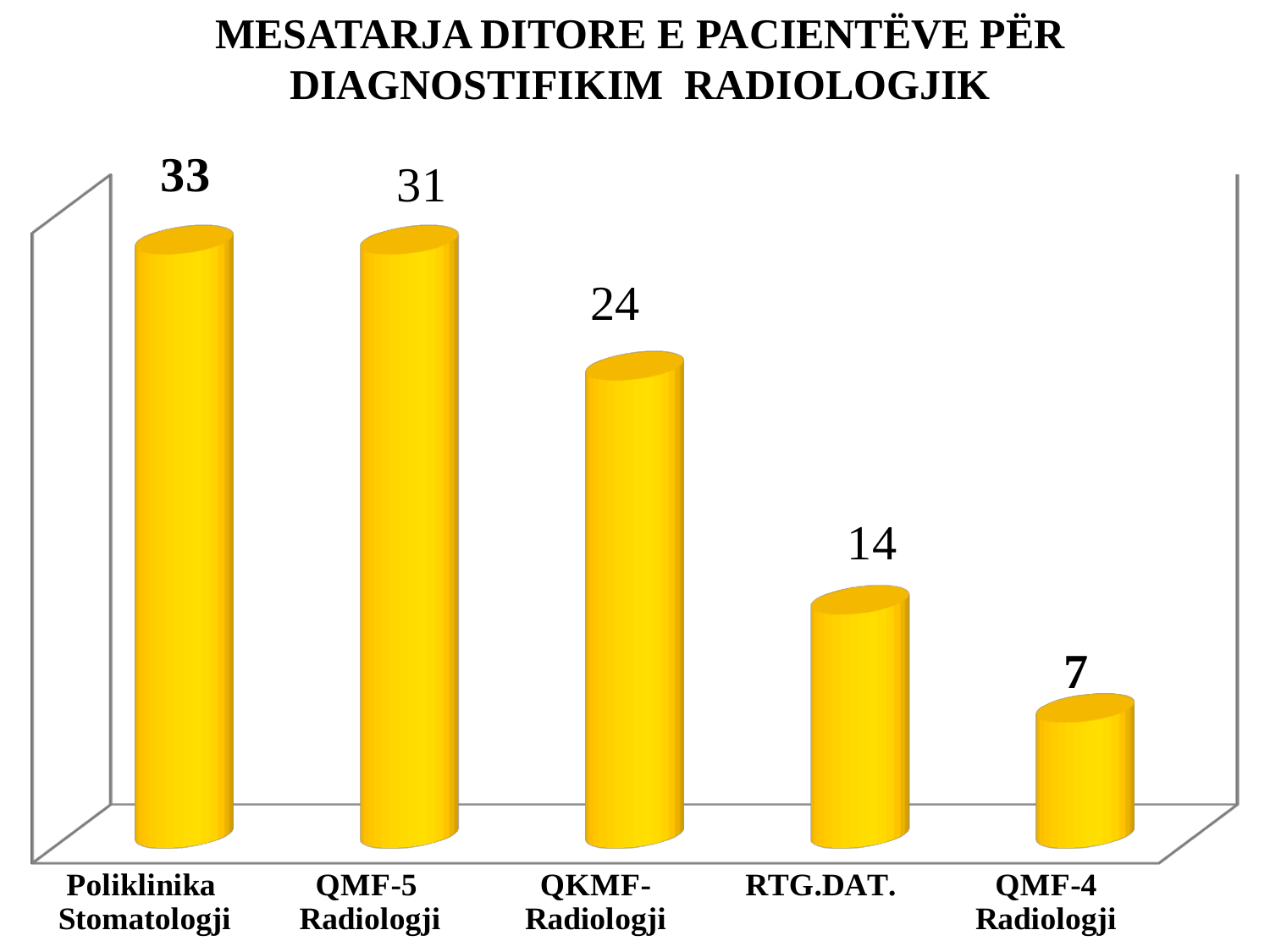
Do the values rise or fall from left to right along the x axis? fall What is the value for QMF-5 Radiologji? 31 What is the difference between the values for Poliklinika Stomatologji and QMF-4 Radiologji? 26 What is the value for RTG.DAT.? 14 What is the value for QKMF-Radiologji? 24 Which category has the lowest value? QMF-4 Radiologji Which category has the highest value? Poliklinika Stomatologji What kind of chart is this? bar chart What is the value for QMF-4 Radiologji? 7 How many categories are shown in the chart? 5 What is the value for Poliklinika Stomatologji? 33 Which is larger, the value for QKMF-Radiologji or the value for RTG.DAT.? QKMF-Radiologji